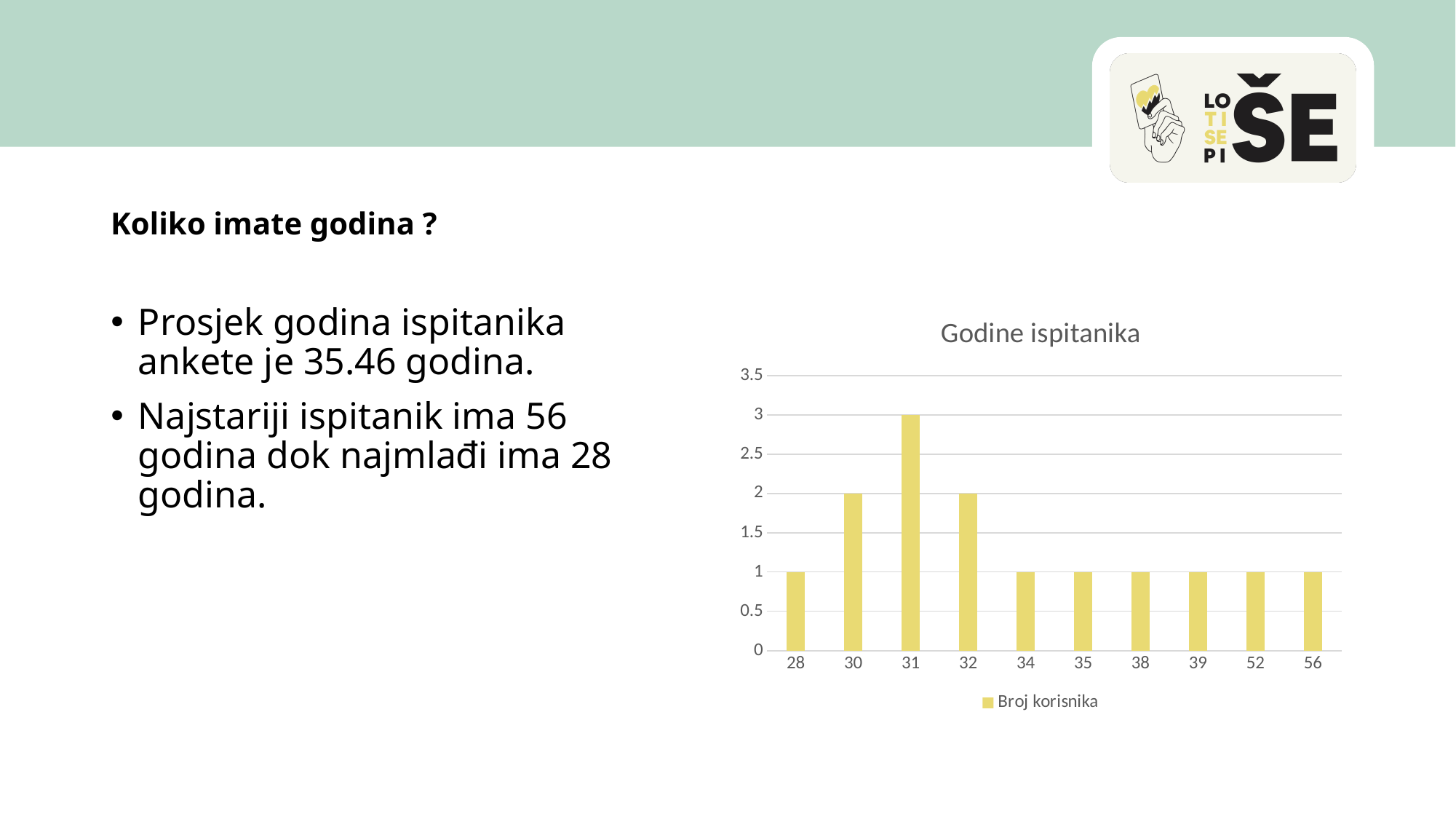
What is the value for age 30? 2 Is the value for age 31 greater or less than 2.5? greater Which is larger, the value for age 30 or the value for age 34? 30 How many series does the legend list? 1 What is the value for age 56? 1 What is the title of the chart? Godine ispitanika Which age category has the highest value? 31 What type of chart is shown on the slide? bar chart What is the value for age 31? 3 What is the difference between the values for age 31 and age 32? 1 How many age categories are shown on the x axis? 10 What is the name of the series in the legend? Broj korisnika